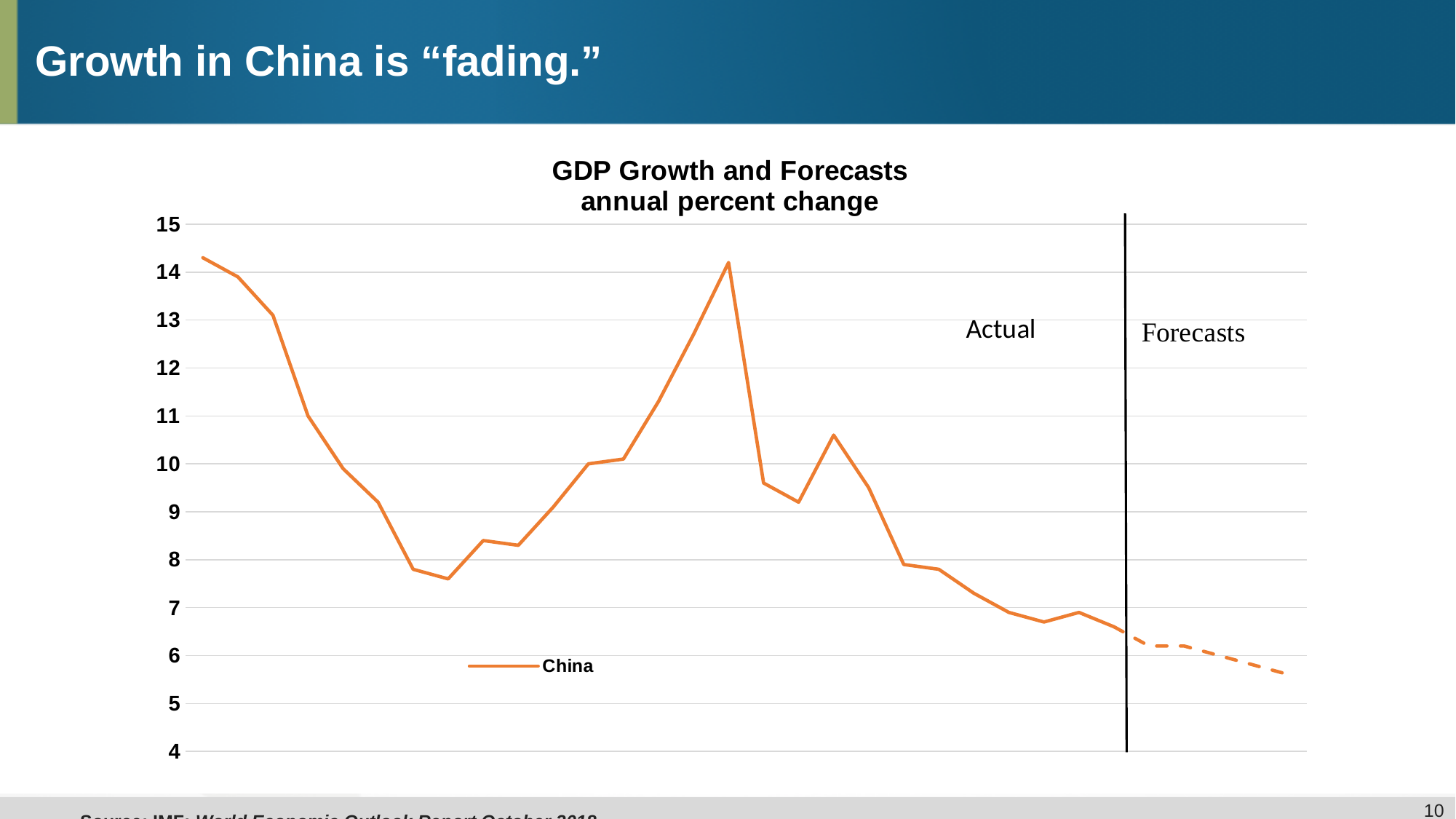
What is the highest value shown on the vertical axis? 15 Is the value at the point where the line crosses into the Forecasts section greater or less than 7? less Is the value at the last forecast point of the line greater or less than 6? less What kind of chart is shown on the slide? line chart Which is larger, the value at the first point of the line or the value at the last point of the line? the first point Overall, does China's GDP growth rise or fall from the left of the chart to the right? fall Is the value at the first point of the line greater or less than 14? greater How many series does the legend list? 1 What is the title of the chart? GDP Growth and Forecasts annual percent change In the Forecasts section of the chart, does the dashed line rise or fall? fall What series name appears in the chart legend? China